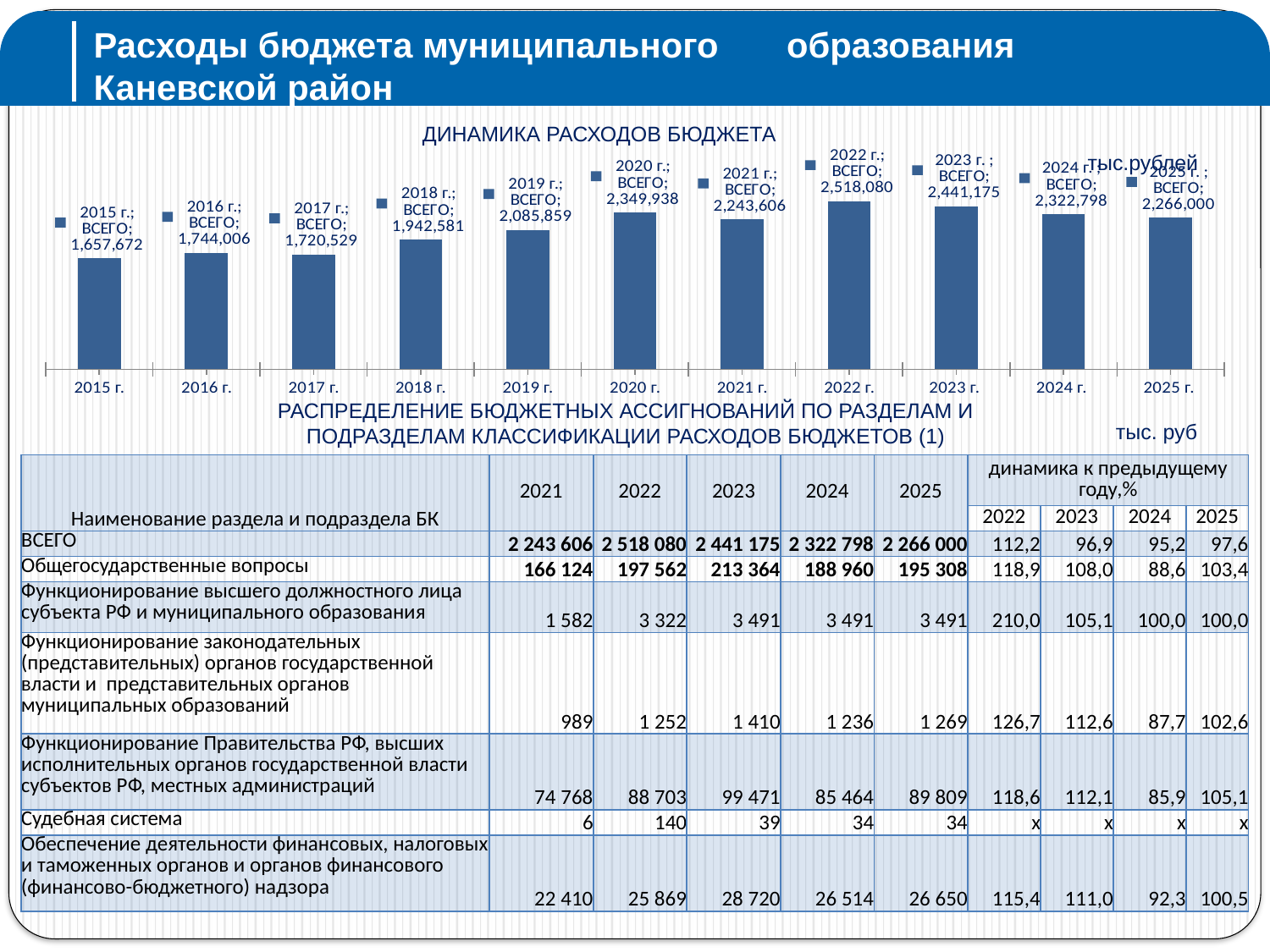
In the "ДИНАМИКА РАСХОДОВ БЮДЖЕТА" chart, what is the difference between the values for 2019 г. and 2018 г.? 143,278 What is the value for 2020 г. in the "ДИНАМИКА РАСХОДОВ БЮДЖЕТА" chart? 2,349,938 How many years (categories) are plotted in the "ДИНАМИКА РАСХОДОВ БЮДЖЕТА" chart? 11 In the "ДИНАМИКА РАСХОДОВ БЮДЖЕТА" chart, do the values rise or fall from 2022 г. to 2025 г.? Fall Which year has the highest value in the "ДИНАМИКА РАСХОДОВ БЮДЖЕТА" chart? 2022 г. In the "ДИНАМИКА РАСХОДОВ БЮДЖЕТА" chart, what is the difference between the values for 2022 г. and 2021 г.? 274,474 In the "ДИНАМИКА РАСХОДОВ БЮДЖЕТА" chart, which is larger: the value for 2016 г. or 2017 г.? 2016 г. What is the value for 2015 г. in the "ДИНАМИКА РАСХОДОВ БЮДЖЕТА" chart? 1,657,672 What is the value for 2025 г. in the "ДИНАМИКА РАСХОДОВ БЮДЖЕТА" chart? 2,266,000 What unit is indicated for the values in the "ДИНАМИКА РАСХОДОВ БЮДЖЕТА" chart? тыс.рублей What type of chart is shown under the title "ДИНАМИКА РАСХОДОВ БЮДЖЕТА"? Bar chart Which year has the lowest value in the "ДИНАМИКА РАСХОДОВ БЮДЖЕТА" chart? 2015 г.